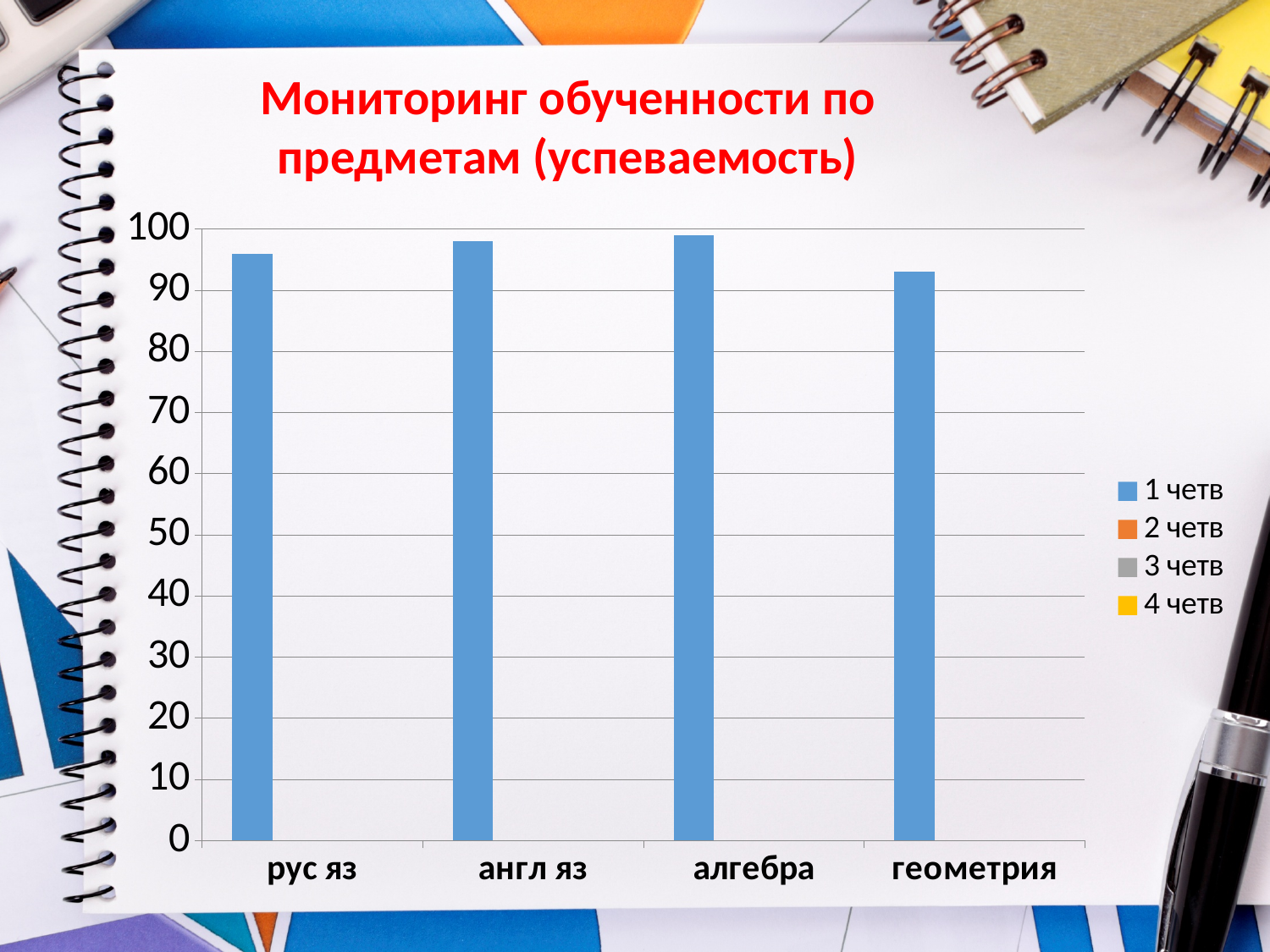
Which category has the lowest bar in the chart? геометрия What is the title of the chart? Мониторинг обученности по предметам (успеваемость) Is the value for англ яз greater or less than 80? greater Which legend entry corresponds to the blue bars in the chart? 1 четв Which is larger, the value for алгебра or the value for геометрия? алгебра Which is larger, the value for рус яз or the value for геометрия? рус яз Is the value for геометрия greater or less than 90? greater How many categories are shown on the x axis of the chart? 4 Is the value for рус яз greater or less than 90? greater How many series does the chart's legend list? 4 What kind of chart is shown on the slide? bar chart